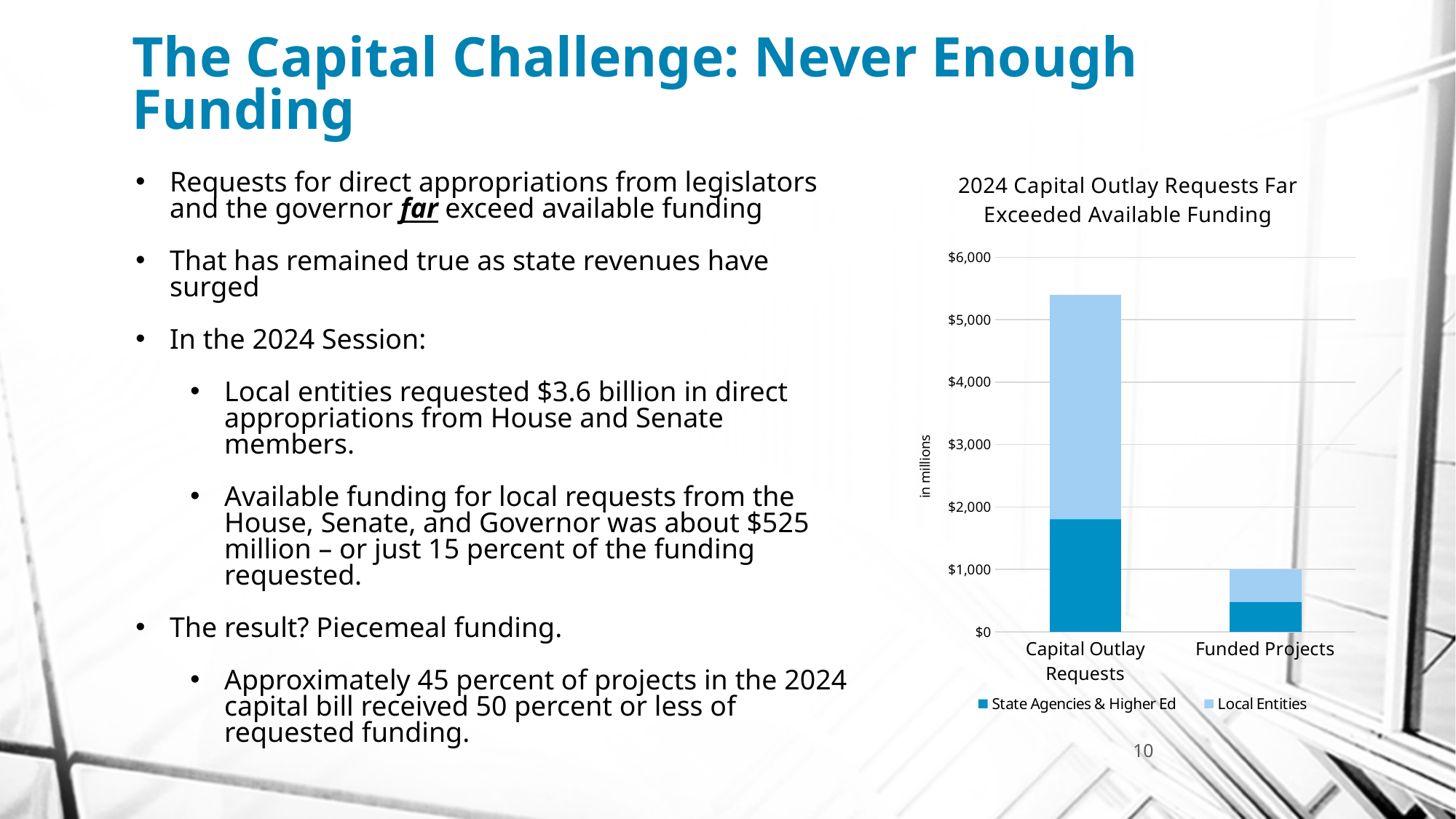
How many series does the chart legend list? 2 Is the State Agencies & Higher Ed portion of the Capital Outlay Requests bar greater or less than $2,000? less Which category has the lowest total bar in the chart? Funded Projects Which category has the taller stacked bar, Capital Outlay Requests or Funded Projects? Capital Outlay Requests Is the total value for Capital Outlay Requests greater or less than $5,000? greater Is the State Agencies & Higher Ed portion of the Funded Projects bar greater or less than $1,000? less What is the title of the chart? 2024 Capital Outlay Requests Far Exceeded Available Funding How many categories are shown on the x axis of the chart? 2 What unit label is shown on the vertical axis of the chart? in millions What kind of chart is shown on the slide? Stacked bar chart